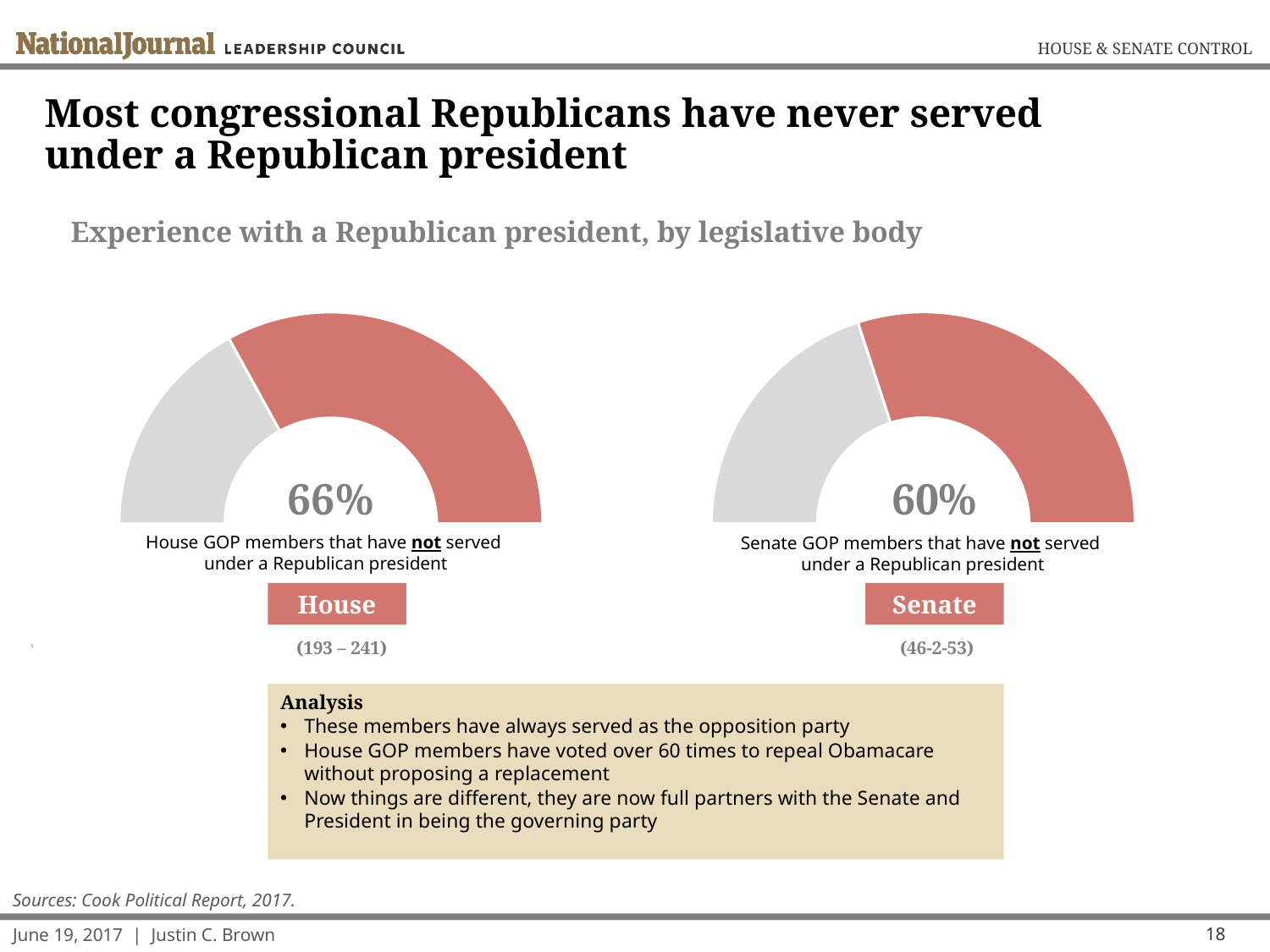
What party breakdown is printed beneath the Senate label? (46-2-53) What kind of chart is used to show the House and Senate percentages? Half-donut (gauge) chart What colour is used for the highlighted share (members who have not served under a Republican president) in both charts? Red What is the subtitle describing the charts on the slide? Experience with a Republican president, by legislative body On the House chart, what percentage of House GOP members have not served under a Republican president? 66% How many charts are shown on the slide? 2 What is the difference in percentage points between the House value (66%) and the Senate value (60%)? 6 percentage points Which legislative body has the higher share of GOP members who have not served under a Republican president, the House or the Senate? House On the Senate chart, is the value greater or less than 50%? greater On the House chart, is the value greater or less than 50%? greater On the Senate chart, what percentage of Senate GOP members have not served under a Republican president? 60% Which chart shows the lower percentage, the House chart or the Senate chart? Senate